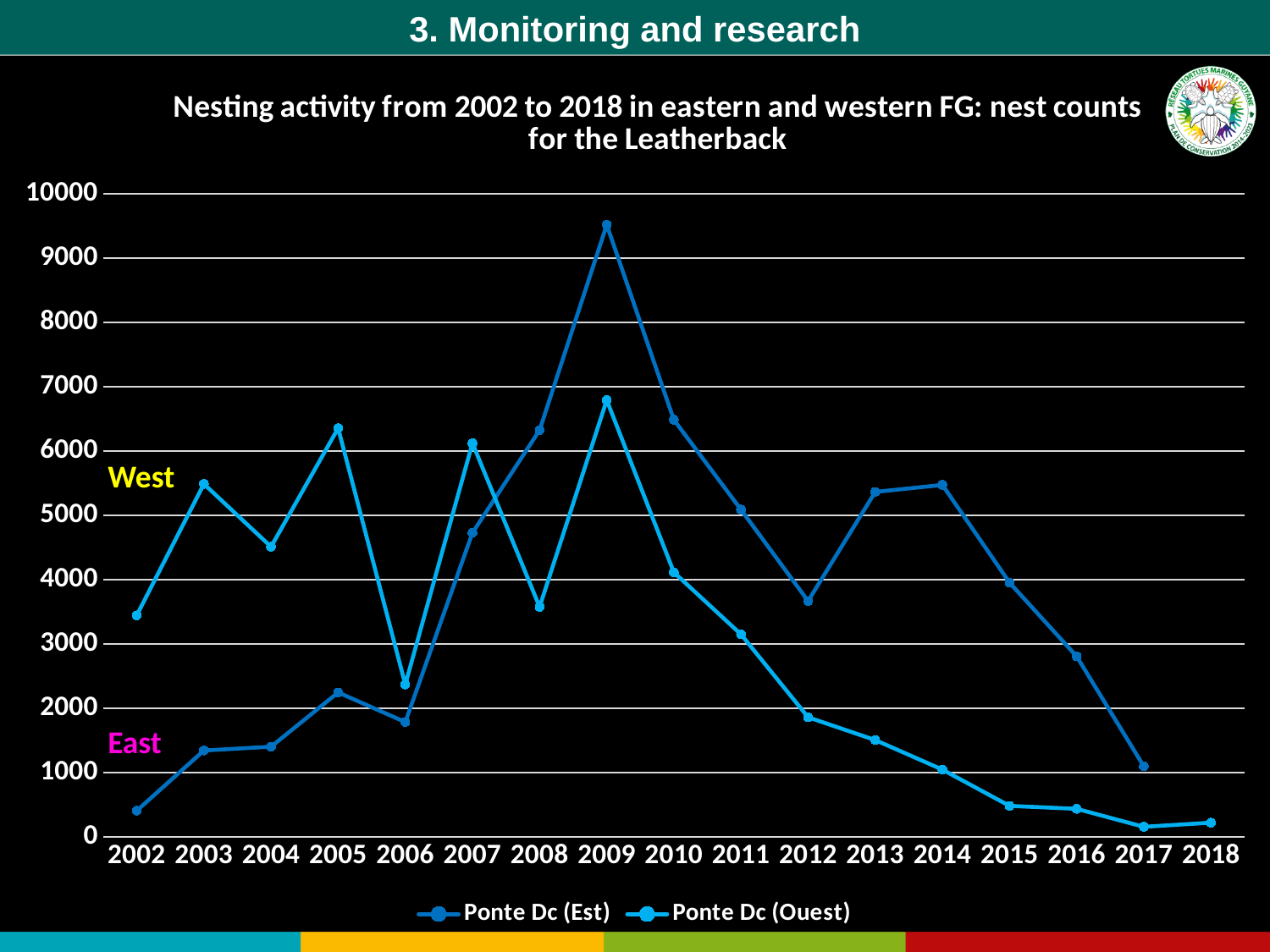
What kind of chart is shown on the slide? line chart What is the title of the chart? Nesting activity from 2002 to 2018 in eastern and western FG: nest counts for the Leatherback Is the value for Ponte Dc (Ouest) in 2002 greater or less than 3000? greater In which year is the Ponte Dc (Est) series at its lowest value? 2002 In which year does the Ponte Dc (Ouest) series reach its highest value? 2009 Does the Ponte Dc (Ouest) series generally rise or fall from 2009 to 2018? fall Is the value for Ponte Dc (Est) in 2012 greater or less than 4000? less In 2003, which series has the larger value, Ponte Dc (Est) or Ponte Dc (Ouest)? Ponte Dc (Ouest) In which year does the Ponte Dc (Est) series reach its highest value? 2009 How many series does the legend list? 2 Is the value for Ponte Dc (Est) in 2009 greater or less than 9000? greater How many years are shown along the x axis? 17